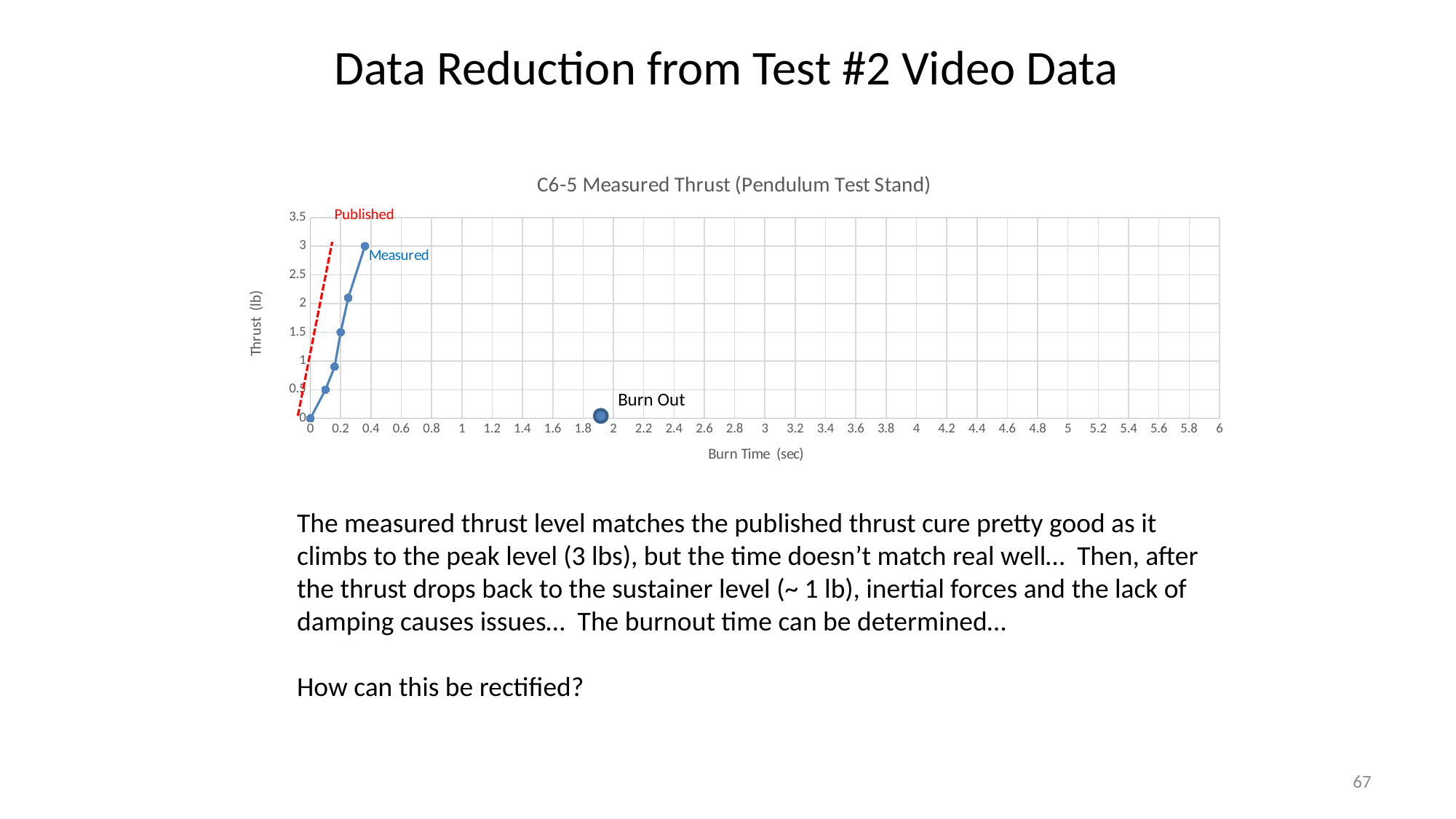
Is the burn time of the Burn Out point greater or less than 1 second? greater Is the burn time at which the Measured series reaches its peak greater or less than 0.2 seconds? greater What is the label of the vertical axis of the chart? Thrust (lb) Is the thrust of the Measured point at about 0.22 seconds greater or less than 1 lb? greater What is the title of the chart? C6-5 Measured Thrust (Pendulum Test Stand) What is the highest value shown on the Thrust (lb) axis? 3.5 Which series reaches a thrust of 3 lb at an earlier burn time, Published or Measured? Published What is the highest value shown on the Burn Time (sec) axis? 6 What thrust value does the Burn Out point have? 0 What is the peak thrust value reached by the Measured series? 3 Does the Measured thrust rise or fall as burn time increases from 0 to about 0.4 seconds? rise What kind of chart is shown on the slide? line chart